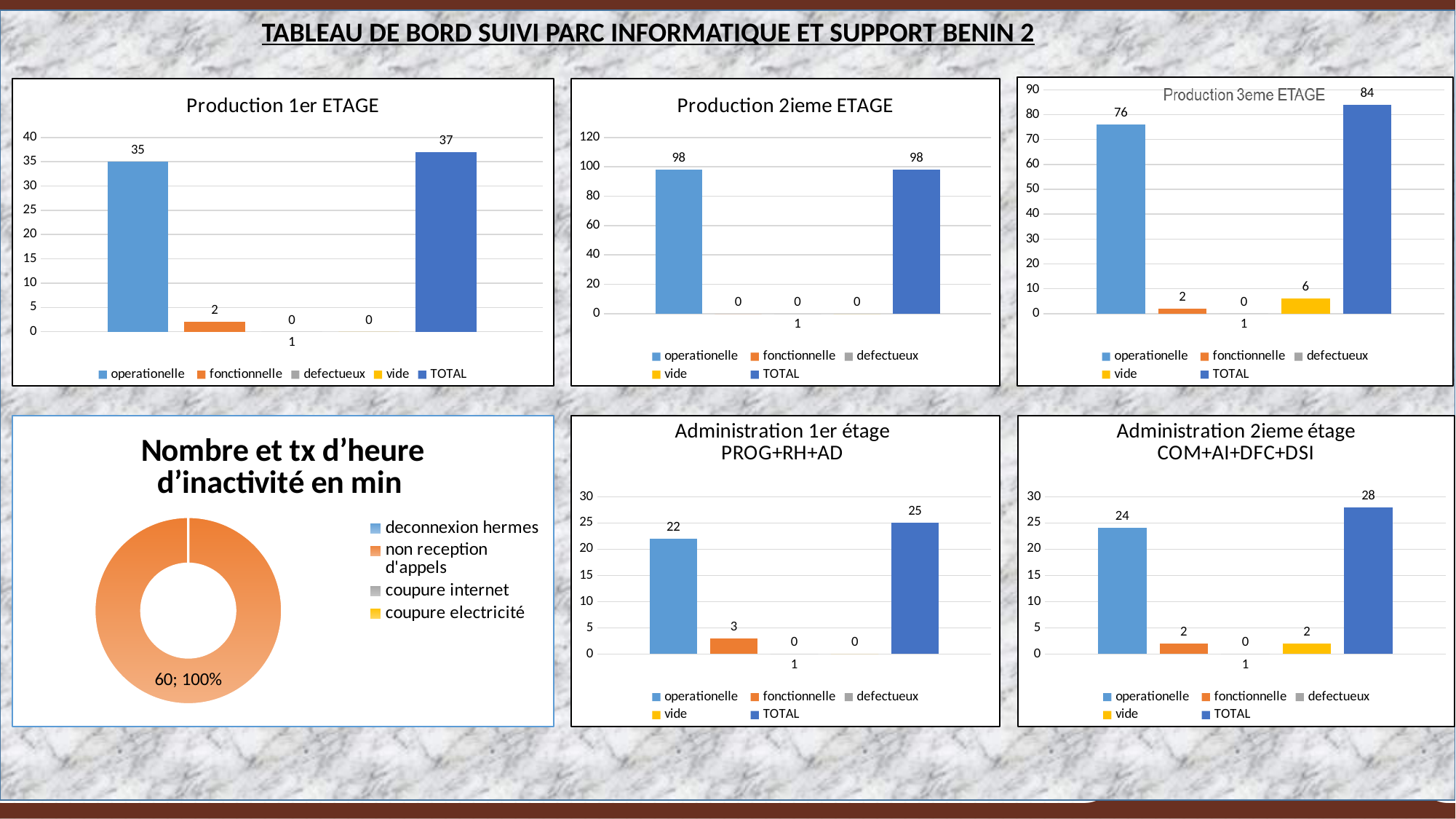
In the 'Production 3eme ETAGE' chart, what is the value for vide? 6 In the 'Administration 2ieme étage COM+AI+DFC+DSI' chart, which series has the highest value? TOTAL In the 'Production 1er ETAGE' chart, what is the value for TOTAL? 37 How many series does the legend of the 'Production 1er ETAGE' chart list? 5 Which is larger: operationelle in 'Production 3eme ETAGE' or operationelle in 'Production 2ieme ETAGE'? Production 2ieme ETAGE In the 'Nombre et tx d'heure d'inactivité en min' chart, what share does the 'non reception d'appels' slice have? 100% What kind of chart is 'Nombre et tx d'heure d'inactivité en min'? Doughnut chart In the 'Production 3eme ETAGE' chart, what is the difference between TOTAL and operationelle? 8 In the 'Administration 2ieme étage COM+AI+DFC+DSI' chart, what is the value for operationelle? 24 In the 'Administration 1er étage PROG+RH+AD' chart, what is the value for fonctionnelle? 3 In the 'Production 2ieme ETAGE' chart, what is the value for operationelle? 98 In the 'Production 1er ETAGE' chart, what is the value for operationelle? 35